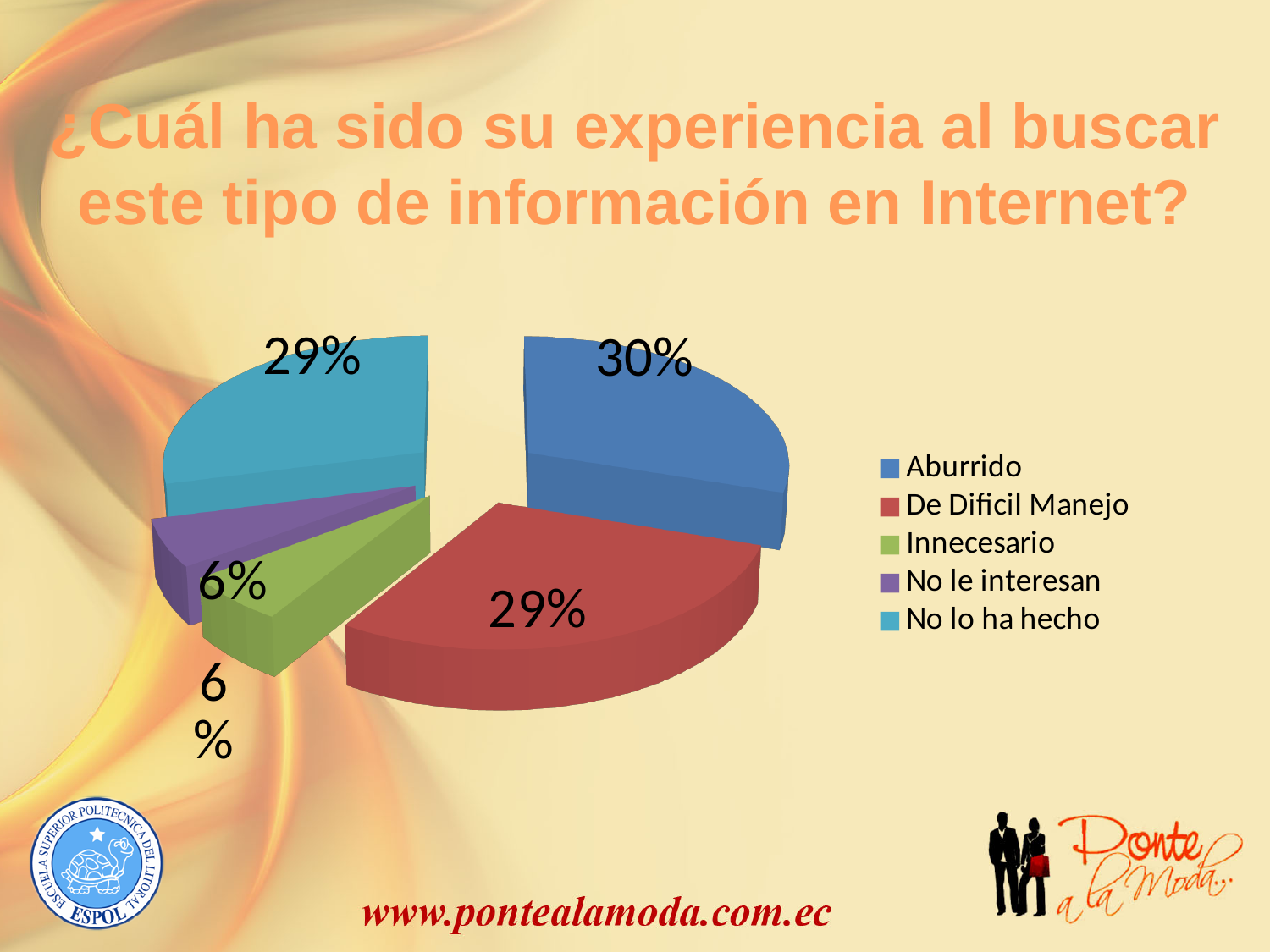
What percentage is shown for Innecesario? 6% Which category has the largest share of the pie? Aburrido How many entries does the legend list? 5 What kind of chart is shown on the slide? Pie chart What is the difference in percentage points between Aburrido and Innecesario? 24 How many slices does the pie chart have? 5 What percentage is shown for No lo ha hecho? 29% Which is larger, the share for Aburrido or the share for No le interesan? Aburrido What percentage does the De Dificil Manejo slice show? 29% What percentage of the pie chart is labelled for Aburrido? 30% What percentage is shown for No le interesan? 6% Which colour represents No lo ha hecho in the legend? Light blue